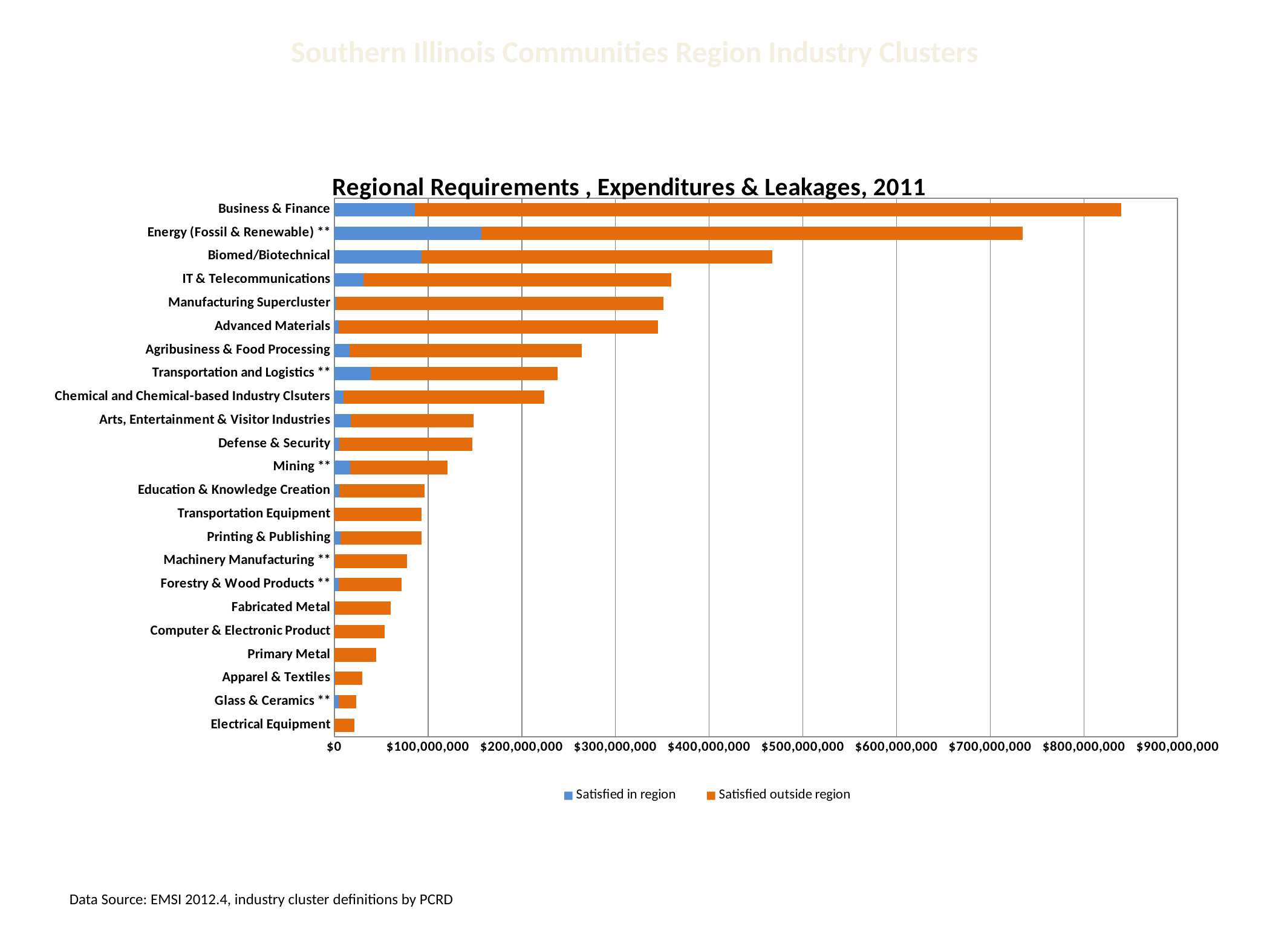
Which has the longer total bar, Biomed/Biotechnical or IT & Telecommunications? Biomed/Biotechnical Is the total bar for Business & Finance greater or less than $800,000,000? greater Which industry cluster has the longest total bar? Business & Finance Which has the larger 'Satisfied in region' segment, Energy (Fossil & Renewable) ** or Business & Finance? Energy (Fossil & Renewable) ** Is the total bar for Agribusiness & Food Processing greater or less than $300,000,000? less What kind of chart is shown on the slide? Stacked bar chart Is the total bar for Energy (Fossil & Renewable) ** greater or less than $800,000,000? less How many series does the legend list? 2 What is the title of the chart? Regional Requirements , Expenditures & Leakages, 2011 How many industry clusters are listed on the chart? 23